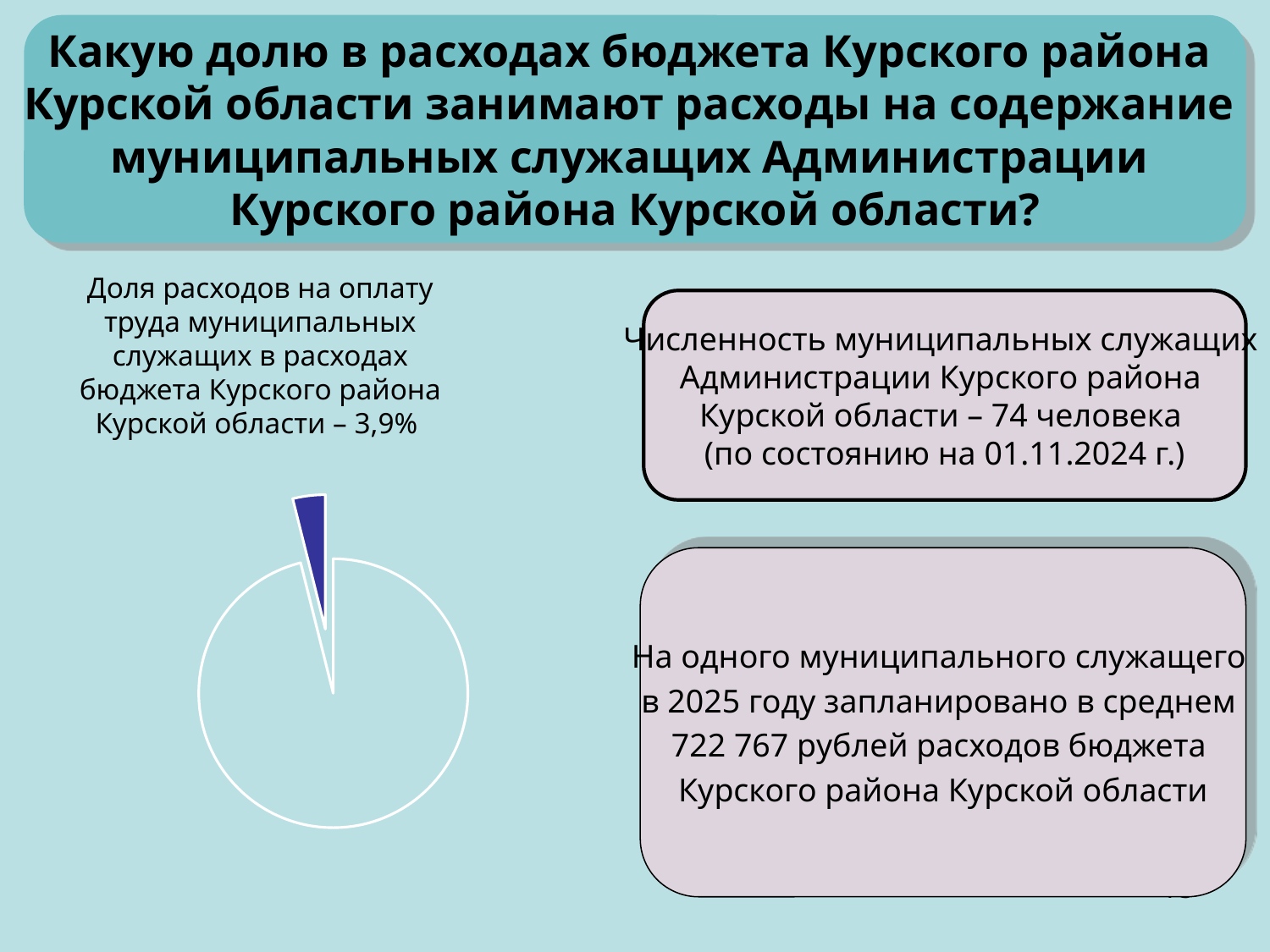
What share of the budget expenditures of the Kursk district does the pie chart's highlighted slice (expenditures on pay of municipal employees) represent? 3,9% How many slices does the pie chart have? 2 Which slice of the pie chart is larger: the dark blue exploded slice or the white remaining slice? the white remaining slice Does the pie chart have a legend? No Which slice of the pie chart is the smallest? the dark blue slice (expenditures on pay of municipal employees, 3,9%) What kind of chart is shown on the slide? pie chart What colour is the exploded slice of the pie chart? dark blue